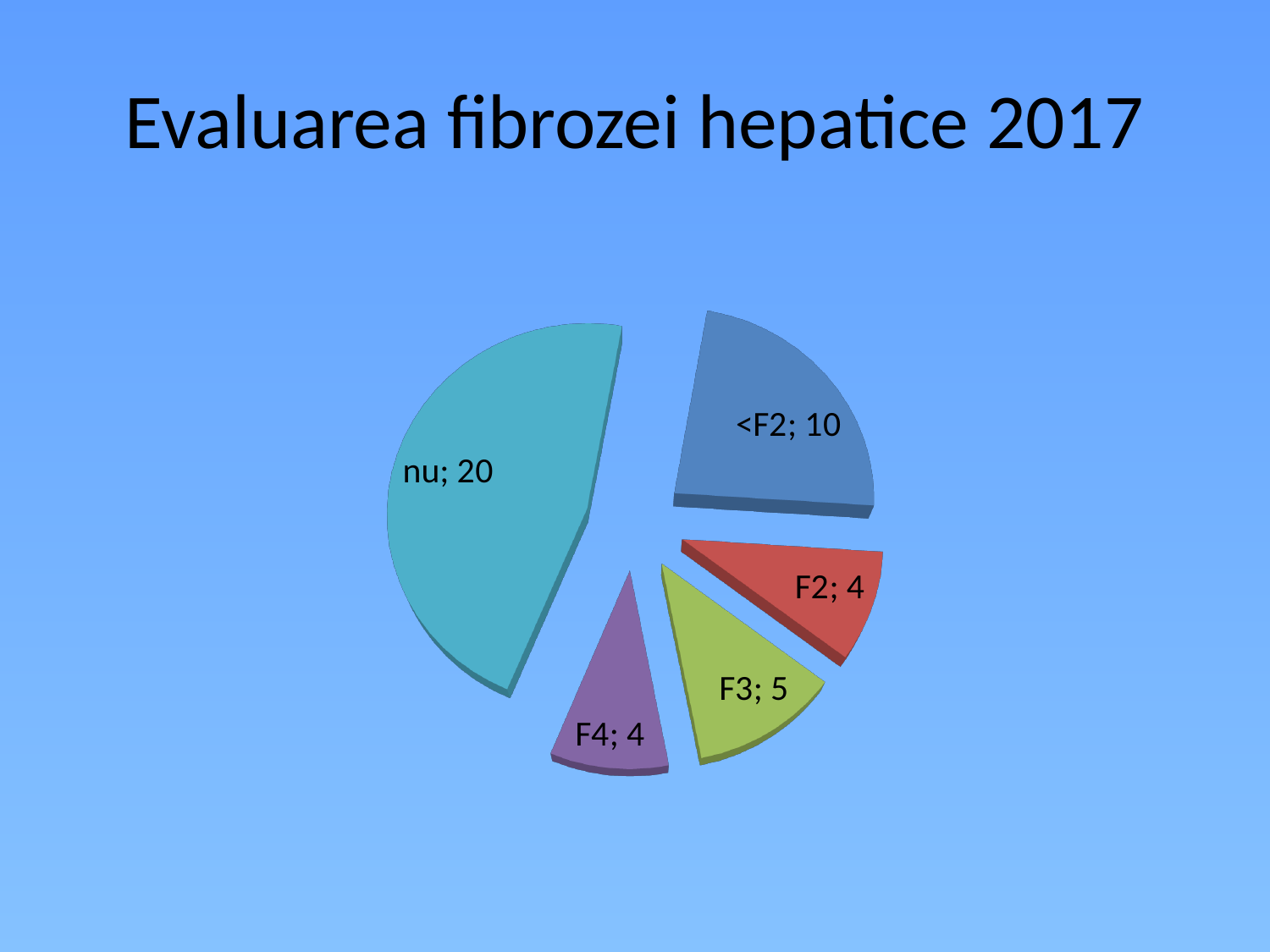
What is the value for the 'F4' slice? 4 What type of chart is shown on the slide? pie chart What is the title of the slide containing the chart? Evaluarea fibrozei hepatice 2017 Which slices share the smallest value? F2 and F4 What is the value for the 'nu' slice? 20 Which slice has the largest value? nu Which is larger, the '<F2' slice or the 'F3' slice? <F2 What is the difference between the 'F3' value and the 'F2' value? 1 How many slices does the pie chart have? 5 What is the difference between the 'nu' value and the '<F2' value? 10 What is the value for the '<F2' slice? 10 What is the value for the 'F3' slice? 5